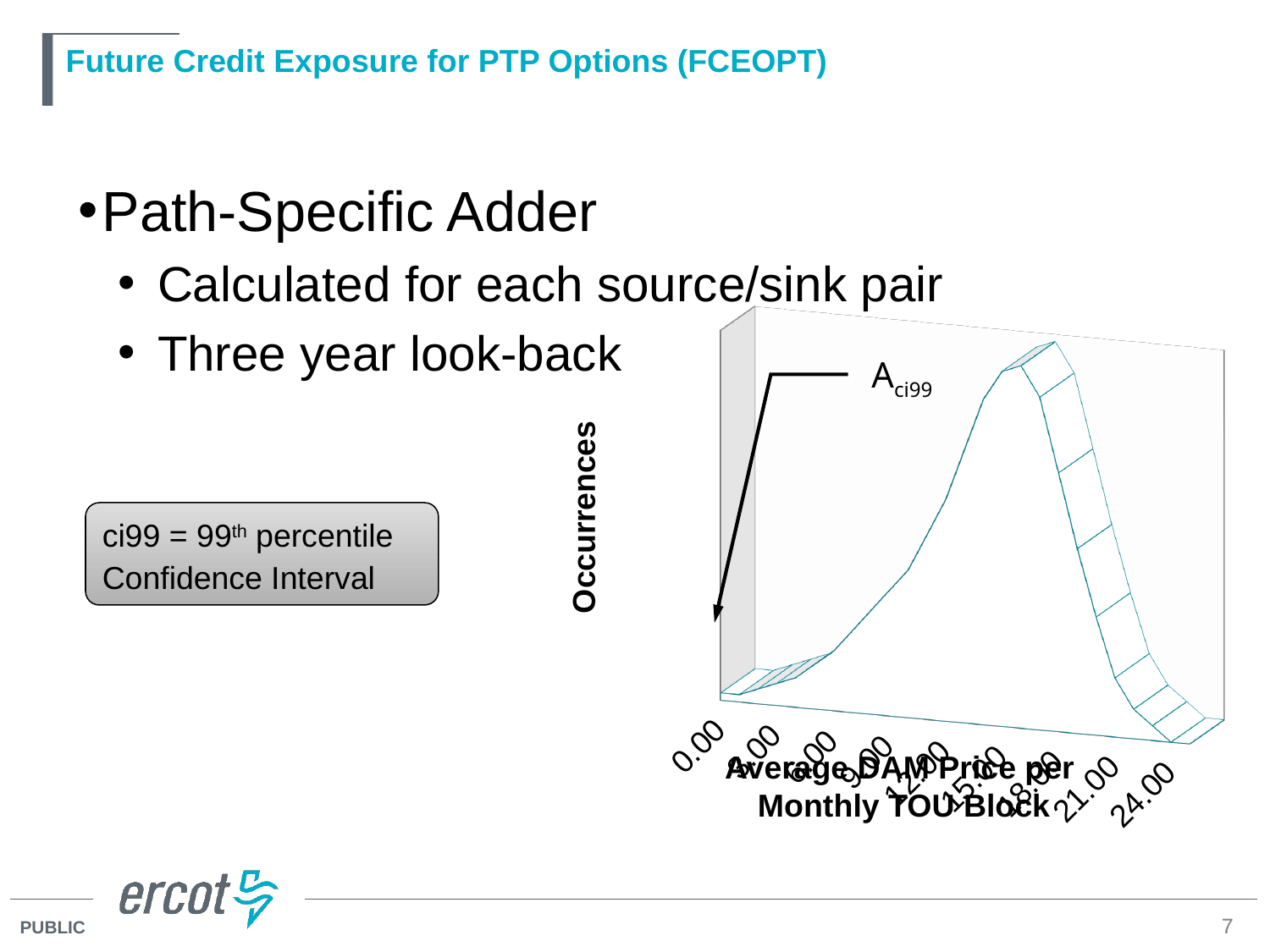
Do the occurrences rise or fall as the average DAM price moves from 0.00 toward the peak of the curve? rise What is the highest tick label shown on the horizontal axis of the chart? 24.00 What is the lowest tick label shown on the horizontal axis of the chart? 0.00 Is the peak of the occurrences curve located at a price greater or less than 12.00 on the horizontal axis? greater Is the peak of the occurrences curve located at a price greater or less than 21.00 on the horizontal axis? less Do the occurrences rise or fall as the average DAM price moves from the peak of the curve toward 24.00? fall What is the label of the horizontal axis of the chart? Average DAM Price per Monthly TOU Block What kind of chart is shown on the slide? 3D area chart What is the label of the vertical axis of the chart? Occurrences